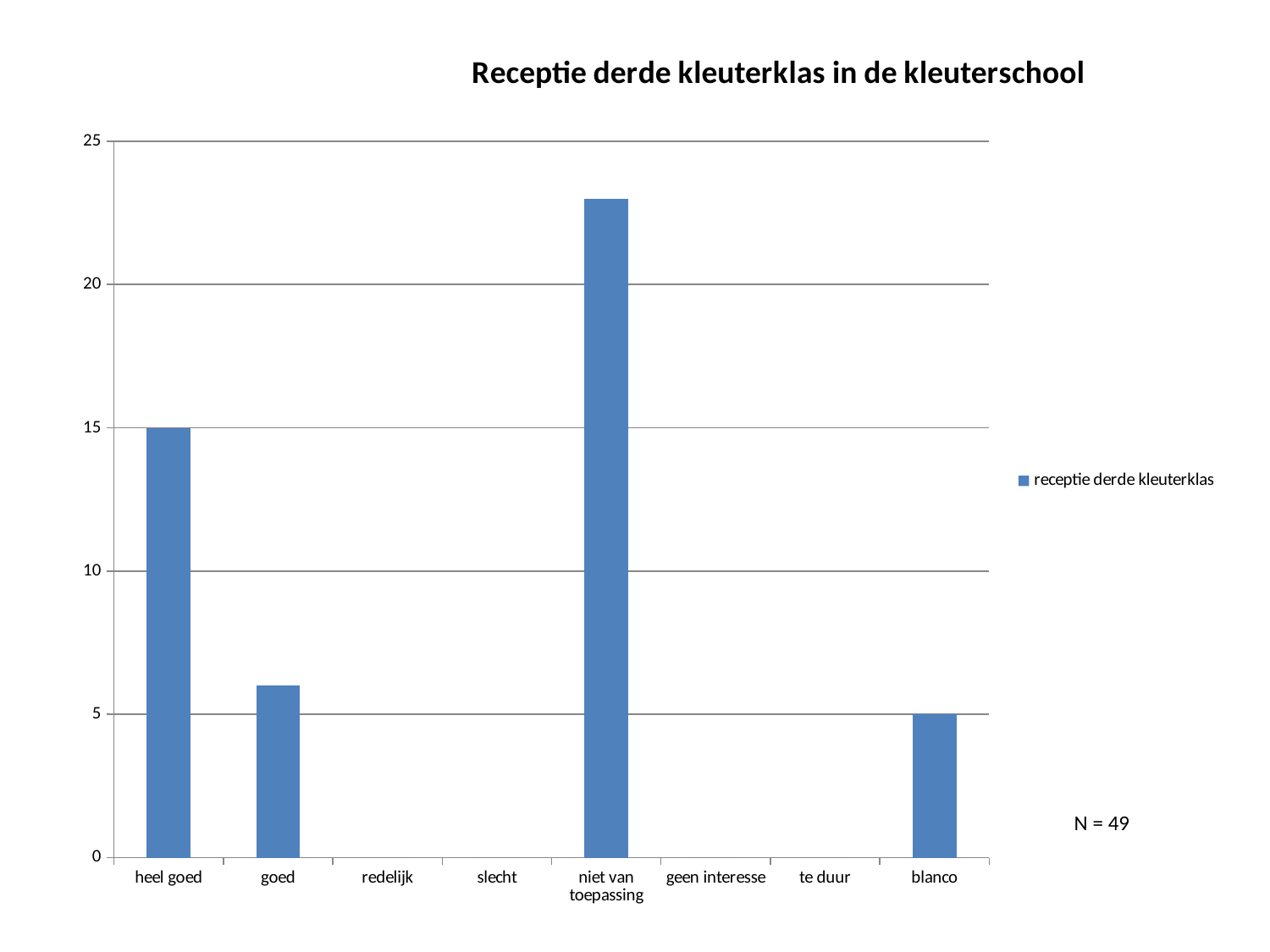
What is the difference between the values for 'heel goed' and 'blanco'? 10 What kind of chart is shown on the slide? bar chart Which is larger, the value for 'heel goed' or the value for 'goed'? heel goed Is the value for 'goed' greater or less than 10? less What is the value for 'heel goed'? 15 What is the value for 'blanco'? 5 Which category has the highest bar? niet van toepassing What series name is shown in the legend? receptie derde kleuterklas How many series does the legend list? 1 How many categories are shown on the x axis of the chart? 8 What is the title of the chart? Receptie derde kleuterklas in de kleuterschool Is the value for 'niet van toepassing' greater or less than 20? greater